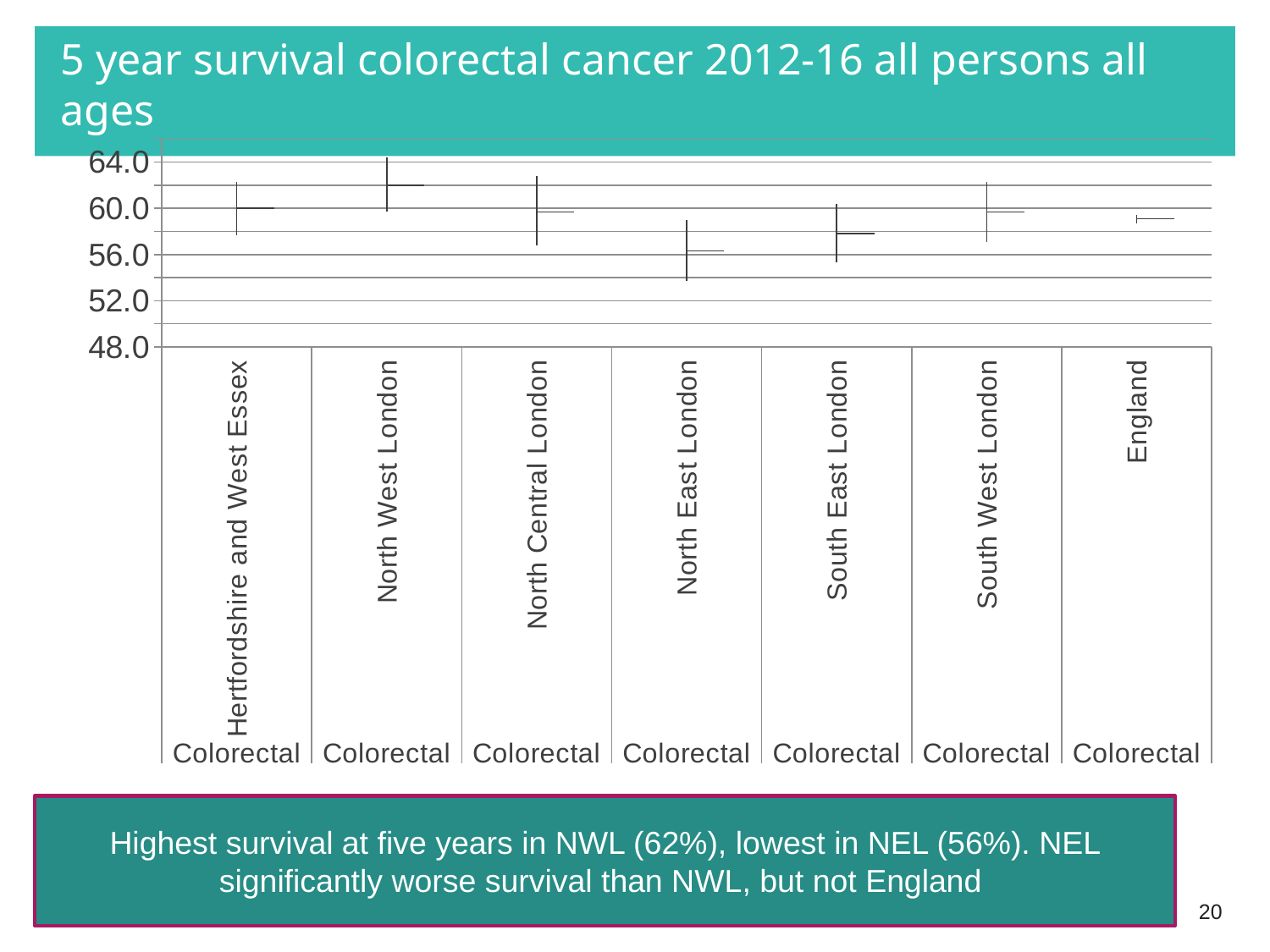
According to the slide, what is the five-year survival for NWL? 62% Is the value for South East London greater or less than 60.0? less Is the value for North East London greater or less than 60.0? less Which area has the highest five-year survival in the chart? North West London Is the value for North West London greater or less than 60.0? greater Which area has the lowest five-year survival in the chart? North East London What is the difference between the five-year survival in NWL and NEL as stated on the slide? 6 percentage points According to the slide, what is the five-year survival for NEL? 56% What is the lowest value shown on the chart's y axis? 48.0 What is the title of the slide containing the chart? 5 year survival colorectal cancer 2012-16 all persons all ages Which has the larger value, Hertfordshire and West Essex or North East London? Hertfordshire and West Essex How many areas are plotted along the x axis of the chart? 7